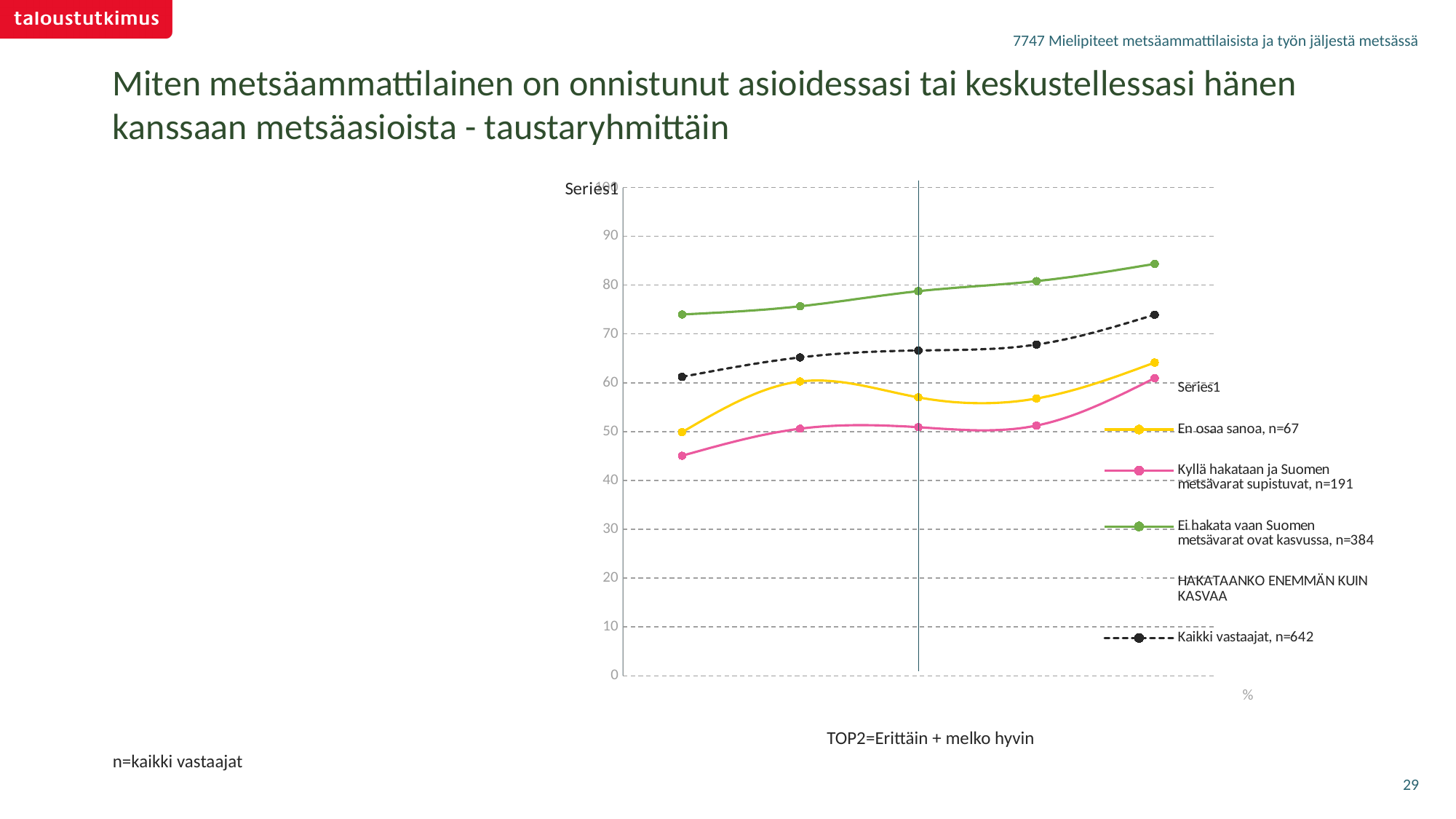
Does the 'Kaikki vastaajat, n=642' line rise or fall from its first point to its last point? rise How many data points does each plotted line have? 5 Is the first point of the 'Ei hakata vaan Suomen metsävarat ovat kasvussa, n=384' line greater or less than 70? greater What line style is used for the 'Kaikki vastaajat, n=642' series? black dashed line At the last point, which is larger: 'Ei hakata vaan Suomen metsävarat ovat kasvussa, n=384' or 'En osaa sanoa, n=67'? Ei hakata vaan Suomen metsävarat ovat kasvussa, n=384 How many lines are plotted on the chart? 4 Is the last point of the 'Ei hakata vaan Suomen metsävarat ovat kasvussa, n=384' line greater or less than 80? greater Is the first point of the 'Kyllä hakataan ja Suomen metsävarat supistuvat, n=191' line greater or less than 50? less Which series has the highest values across the chart? Ei hakata vaan Suomen metsävarat ovat kasvussa, n=384 Which series has the lowest values across the chart? Kyllä hakataan ja Suomen metsävarat supistuvat, n=191 What kind of chart is shown on the slide? line chart